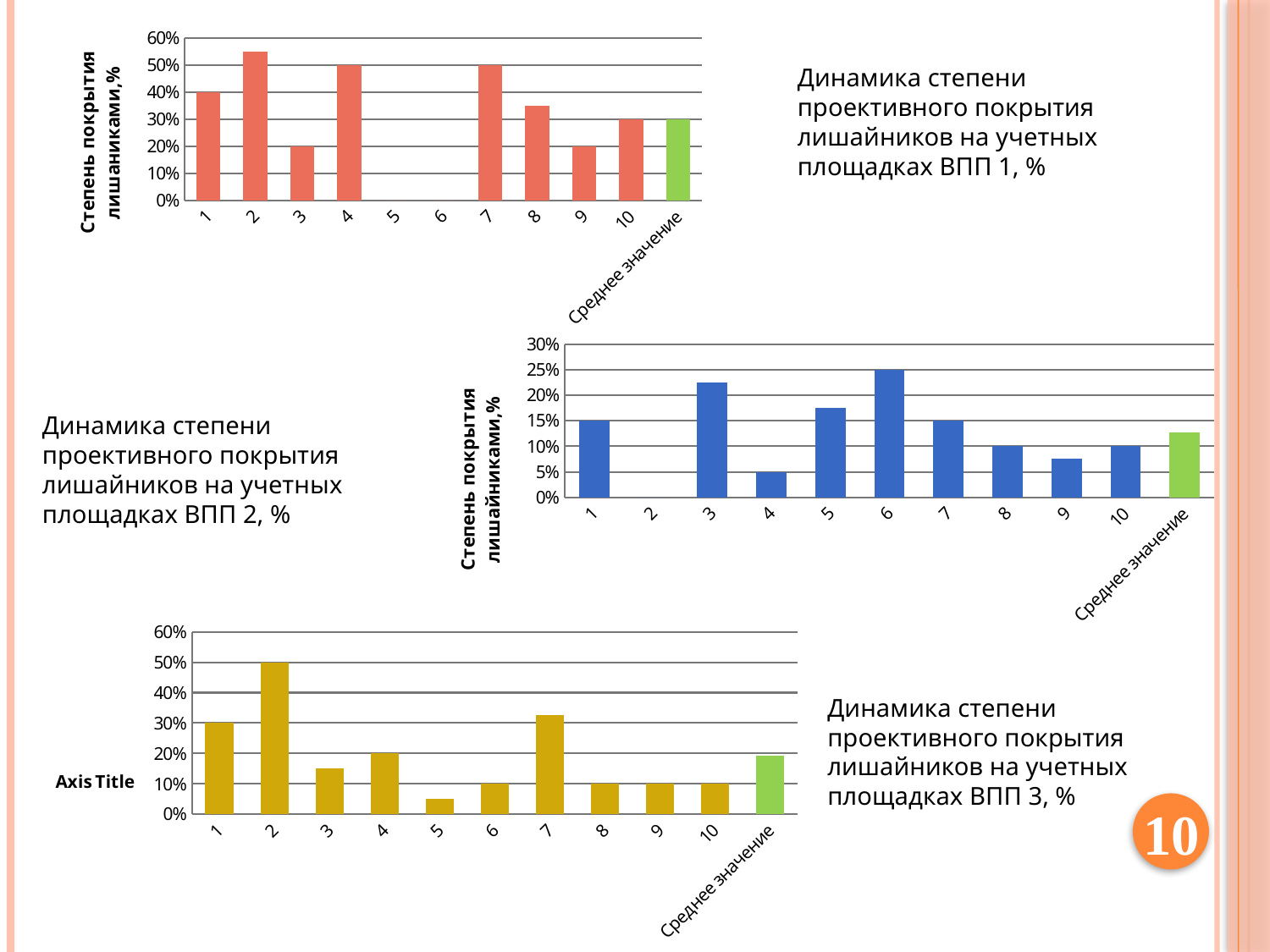
On the chart for ВПП 3 (bottom), which plot has the lowest value? 5 On the chart for ВПП 1 (top), which plot has the highest value? 2 On the chart for ВПП 1 (top), is the value for plot 8 greater or less than 30%? greater On the chart for ВПП 3 (bottom), what is the value for plot 2? 50% On the chart for ВПП 1 (top), what is the difference between the values for plot 4 and plot 10? 20% On the chart for ВПП 2 (middle), which plot has the highest value? 6 On the chart for ВПП 1 (top), what is the value for plot 1? 40% How many categories are shown on the x axis of the chart for ВПП 3 (bottom)? 11 On the chart for ВПП 3 (bottom), which is larger, the value for plot 1 or plot 4? plot 1 On the chart for ВПП 1 (top), what is the value for Среднее значение? 30% On the chart for ВПП 2 (middle), is the value for plot 3 greater or less than 20%? greater On the chart for ВПП 2 (middle), what is the value for plot 6? 25%